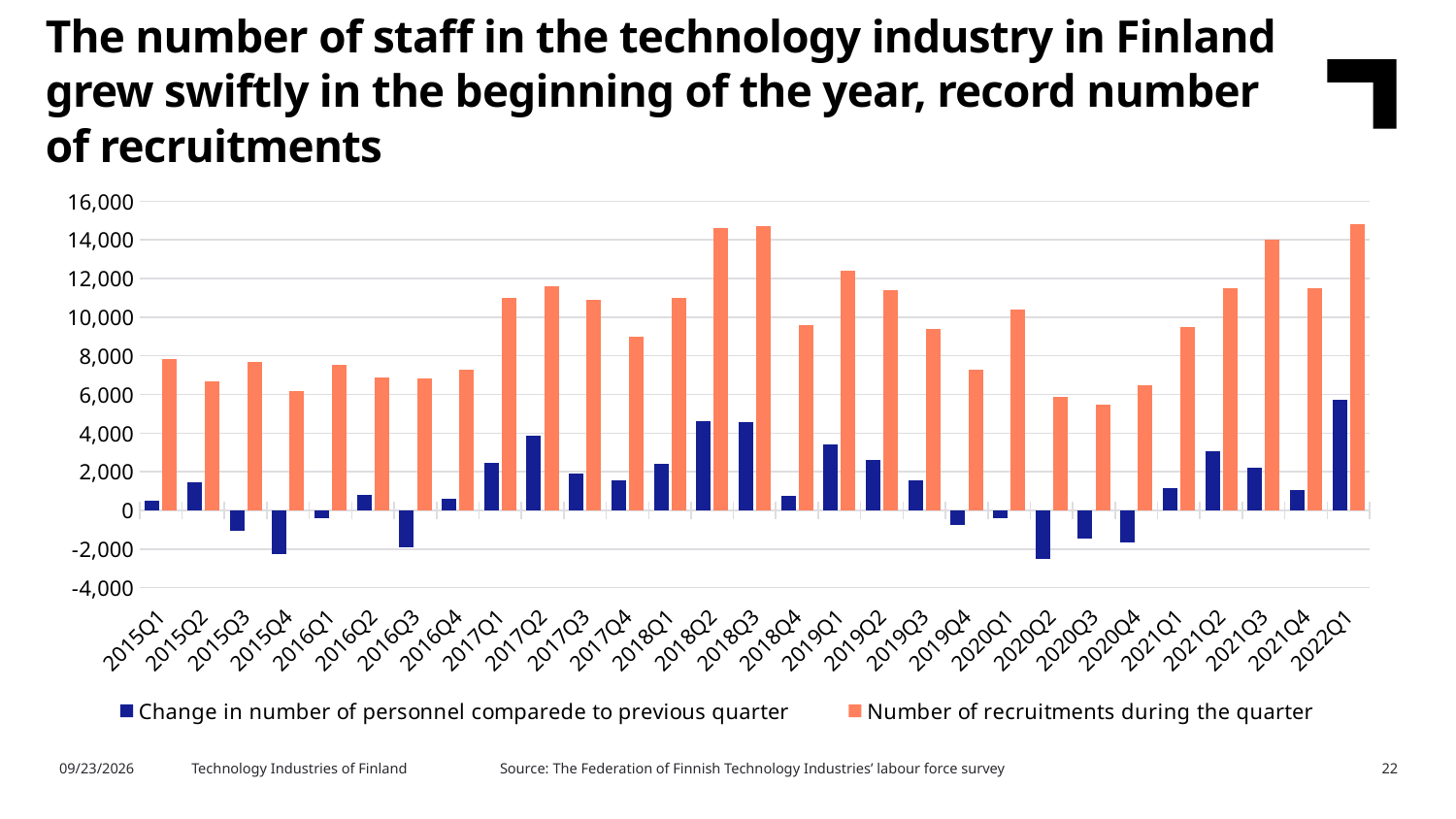
Do the number of recruitments during the quarter rise or fall from 2020Q3 to 2021Q3? rise Which quarter has more recruitments during the quarter, 2018Q2 or 2020Q3? 2018Q2 Which quarter has the highest value for change in number of personnel compared to previous quarter? 2022Q1 Is the number of recruitments during the quarter for 2019Q1 greater or less than 10,000? greater What kind of chart is shown on the slide? bar chart How many series does the legend list? 2 How many quarters are shown on the x axis? 29 Is the change in number of personnel for 2022Q1 greater or less than 4,000? greater Which quarter has a larger change in number of personnel compared to previous quarter, 2017Q2 or 2017Q3? 2017Q2 Is the number of recruitments during the quarter for 2018Q2 greater or less than 14,000? greater